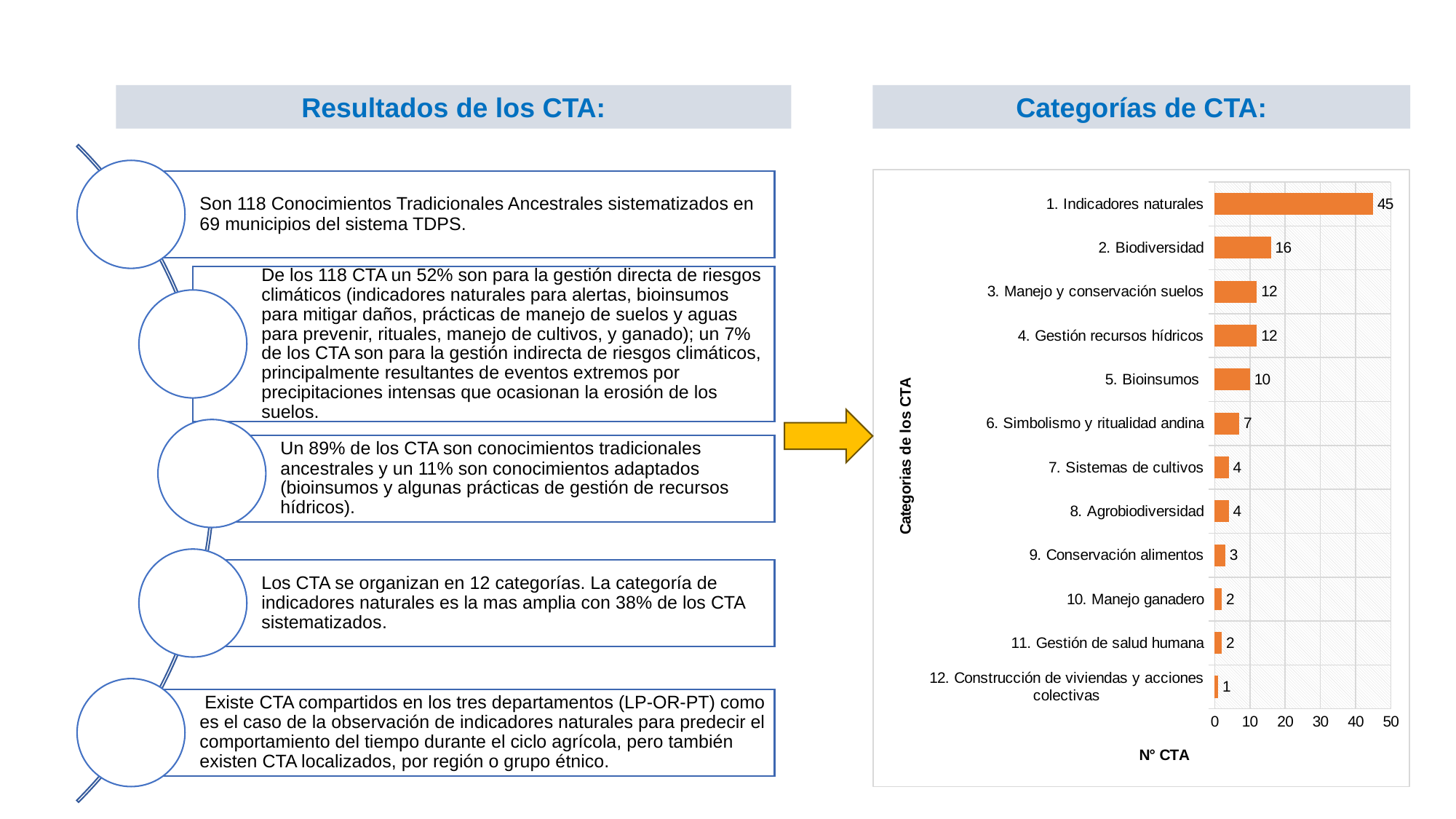
Which is larger, the value for '2. Biodiversidad' or the value for '4. Gestión recursos hídricos'? 2. Biodiversidad Which category has the lowest value in the chart? 12. Construcción de viviendas y acciones colectivas What is the difference between the values for '2. Biodiversidad' and '6. Simbolismo y ritualidad andina'? 9 What is the difference between the values for '1. Indicadores naturales' and '2. Biodiversidad'? 29 What kind of chart is shown on the slide? bar chart What is the value for '1. Indicadores naturales' in the chart? 45 How many categories are shown in the chart? 12 Which category has the highest value in the chart? 1. Indicadores naturales What is the value for '9. Conservación alimentos' in the chart? 3 Is the value for '1. Indicadores naturales' greater or less than 40? greater What is the label of the horizontal axis of the chart? N° CTA What is the value for '5. Bioinsumos' in the chart? 10